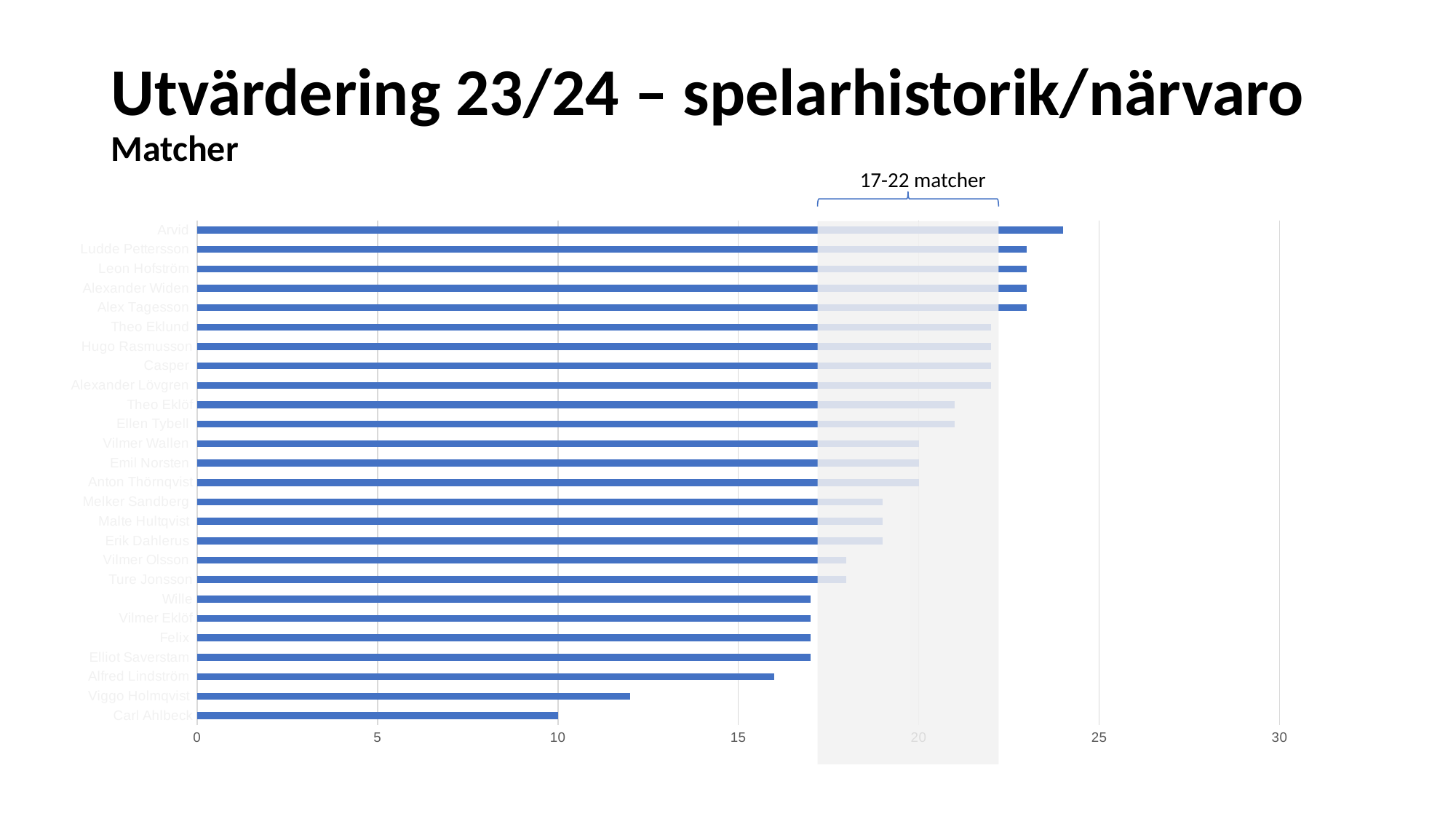
Is the value for Arvid greater or less than 20? greater What range of matches does the shaded band annotation above the chart indicate? 17-22 matcher Who has more matches, Theo Eklund or Viggo Holmqvist? Theo Eklund Do the bar lengths increase or decrease from the top of the chart to the bottom? Decrease Is the value for Alfred Lindström greater or less than 15? greater Which player has the highest number of matches? Arvid Which player has the lowest number of matches? Carl Ahlbeck Is the value for Viggo Holmqvist greater or less than 15? less Who has more matches, Carl Ahlbeck or Ellen Tybell? Ellen Tybell What kind of chart is shown on the slide? Bar chart How many matches does Carl Ahlbeck have? 10 How many players are listed in the chart? 26